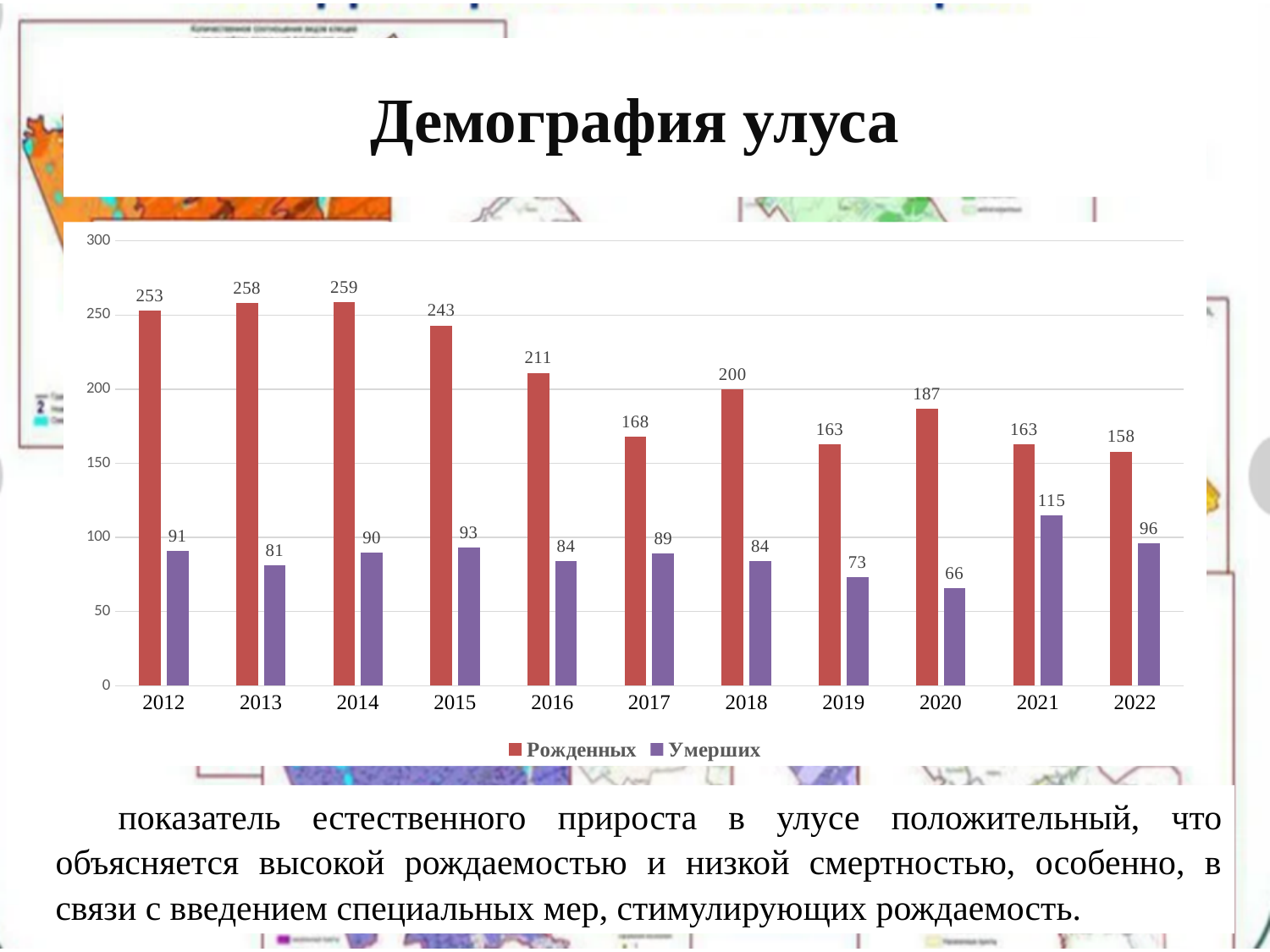
Which year has the lowest value for Умерших? 2020 What is the difference between Рожденных and Умерших in 2012? 162 Which year has the highest value for Рожденных? 2014 Do the values for Рожденных generally rise or fall from 2014 to 2022? Fall What is the value for Рожденных in 2014? 259 Which colour represents the Умерших series? Purple What is the value for Умерших in 2021? 115 Which is larger: Умерших in 2021 or Умерших in 2022? Умерших in 2021 How many years are shown on the x axis? 11 How many series does the legend list? 2 What kind of chart is shown on the slide? Bar chart What is the title of the slide? Демография улуса